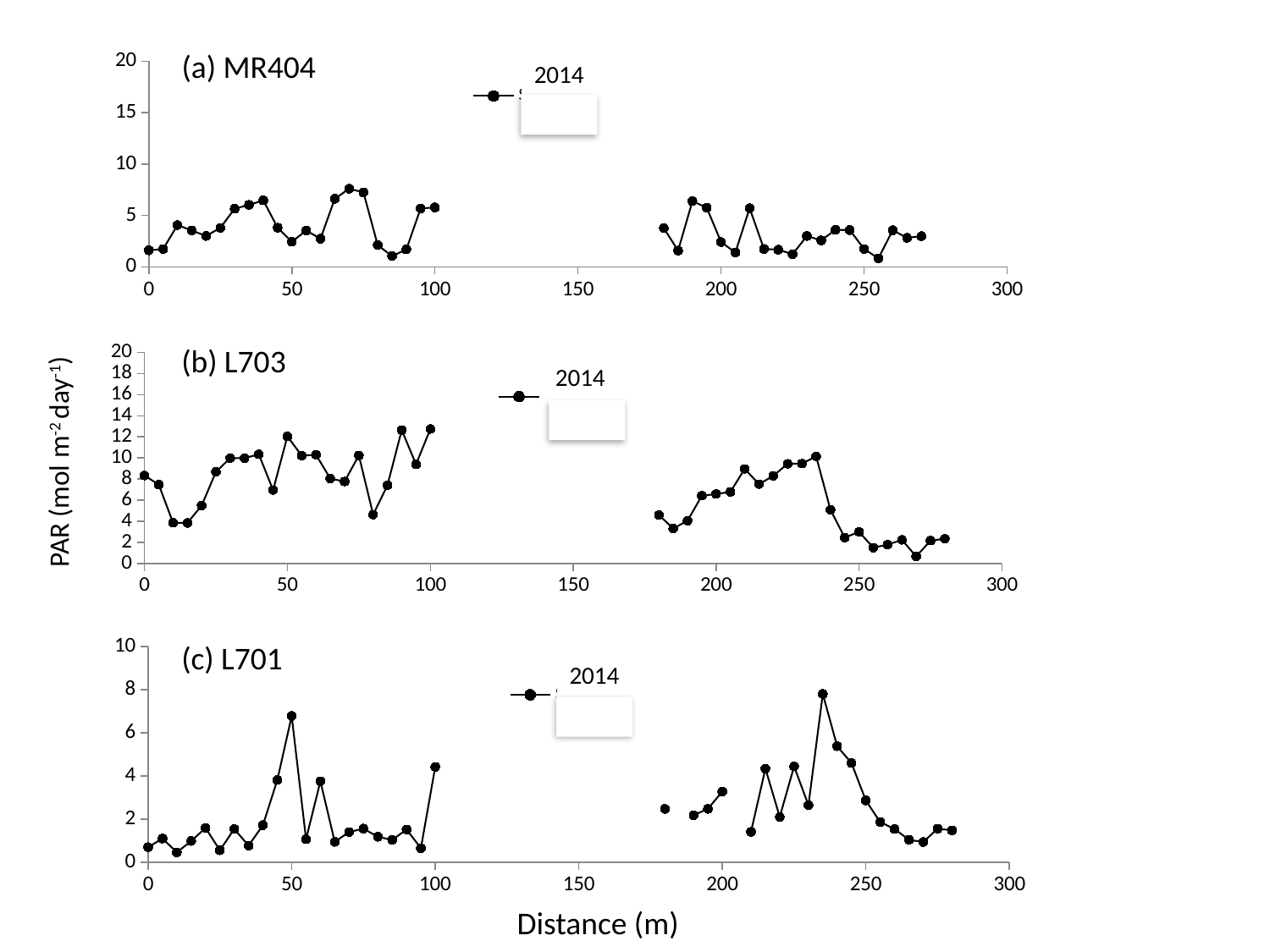
In chart (c) L701, at which distance is the highest value plotted? 235 m In chart (a) MR404, is the value at a distance of 70 m greater or less than 5? greater In chart (c) L701, is the value at a distance of 10 m greater or less than 2? less What year does the legend of chart (c) L701 show? 2014 In chart (b) L703, do the values rise or fall between 235 m and 245 m? fall In chart (b) L703, is the value at a distance of 50 m greater or less than 10? greater What is the x-axis label shared by the charts on the slide? Distance (m) What kind of chart is chart (a) MR404? line chart In chart (a) MR404, which is larger, the value at 70 m or the value at 85 m? 70 m